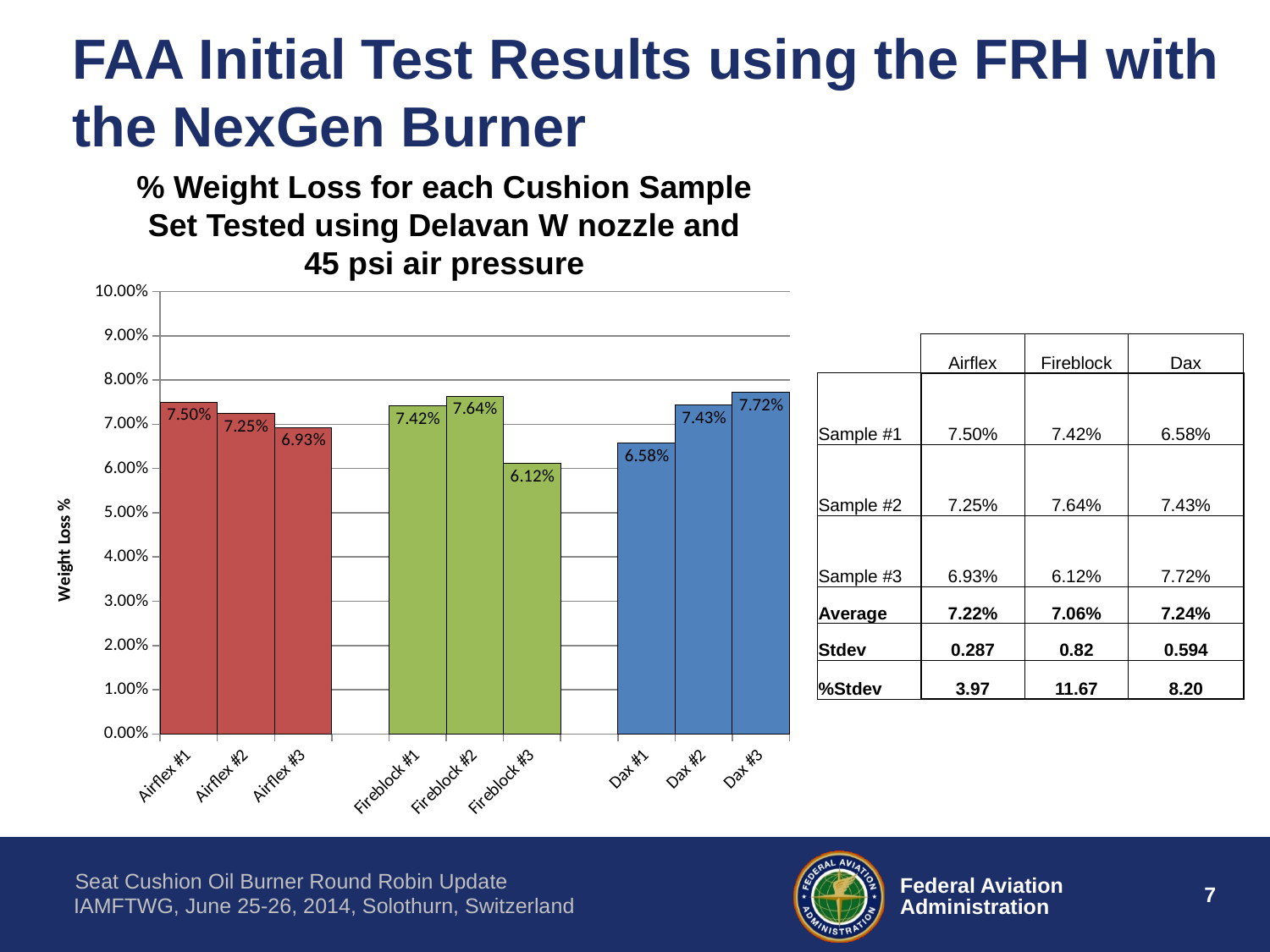
Which has a larger % weight loss, Dax #1 or Airflex #2? Airflex #2 Which cushion sample has the highest % weight loss? Dax #3 What is the % weight loss value for Dax #2? 7.43% What is the difference in % weight loss between Fireblock #2 and Fireblock #3? 1.52% What is the difference in % weight loss between Airflex #1 and Airflex #3? 0.57% What is the % weight loss value for Fireblock #3? 6.12% What kind of chart is shown on the slide? bar chart How many cushion samples are plotted in the chart? 9 Which cushion sample has the lowest % weight loss? Fireblock #3 Is the value for Fireblock #3 greater or less than 7.00%? less Do the % weight loss values rise or fall from Airflex #1 to Airflex #3? fall What is the % weight loss value for Airflex #1? 7.50%